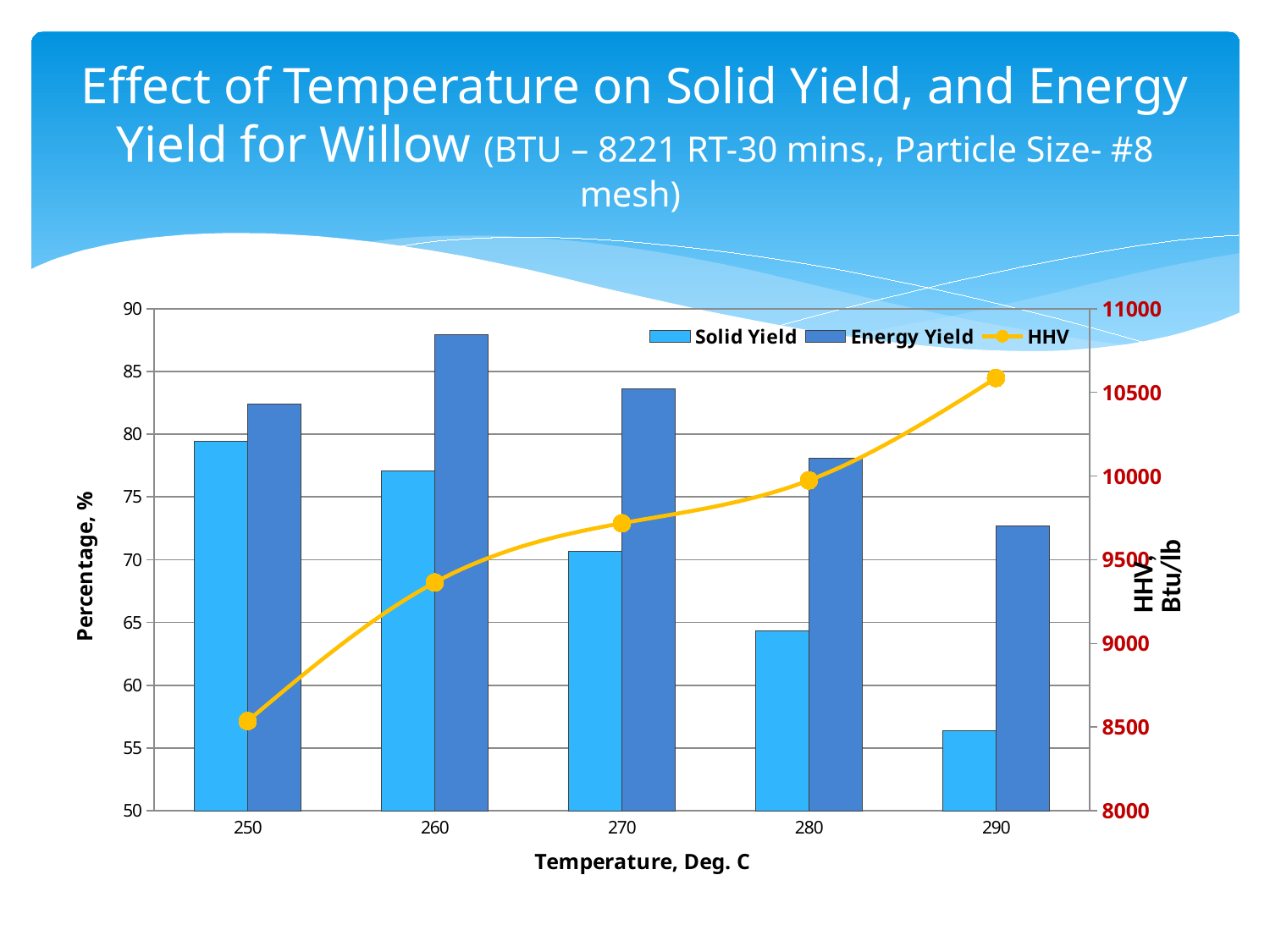
Is the HHV value at 250 greater or less than 9000? less How many temperature values are plotted along the x axis? 5 Does HHV rise or fall as temperature increases from 250 to 290? Rise What kind of chart is shown on the slide? A combined bar and line chart Which is larger at 260: Solid Yield or Energy Yield? Energy Yield Is the Solid Yield value at 270 greater or less than 75? less Does Solid Yield rise or fall as temperature increases from 250 to 290? Fall At which temperature is Solid Yield highest? 250 At which temperature is Energy Yield lowest? 290 At which temperature is Energy Yield highest? 260 At which temperature is Solid Yield lowest? 290 How many series does the legend list? 3